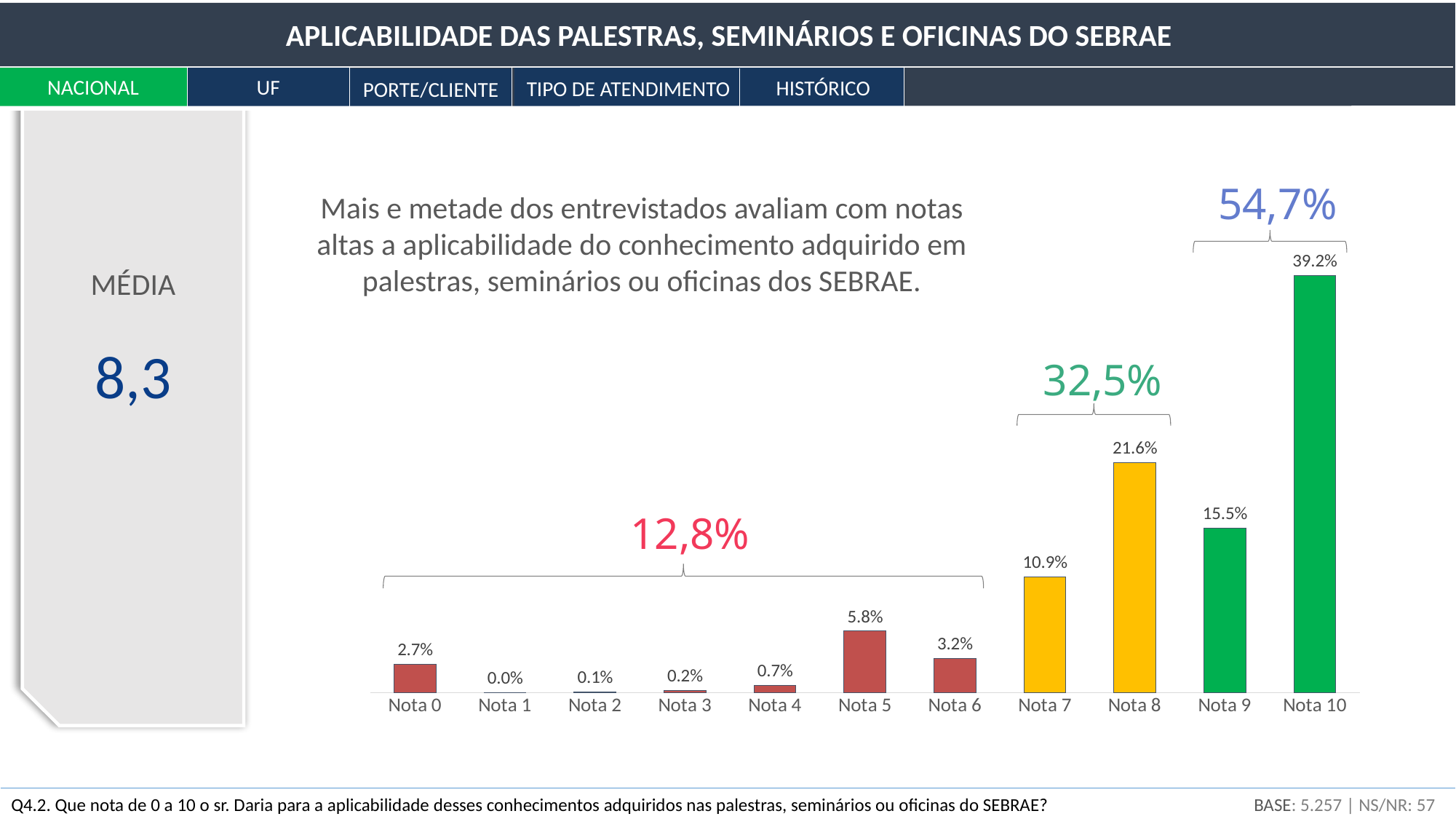
What is the difference between the values for Nota 10 and Nota 9? 23.7% What is the MÉDIA (average) value shown on the left panel? 8,3 What is the combined share shown for Nota 9 and Nota 10 above the bracket? 54,7% What is the combined share shown for Nota 0 through Nota 6 above the bracket? 12,8% What kind of chart is shown? bar chart What is the value for Nota 5? 5.8% Which category has the lowest value? Nota 1 What is the value for Nota 8? 21.6% Which category has the highest value? Nota 10 What is the value for Nota 10? 39.2% Which is larger, the value for Nota 7 or the value for Nota 6? Nota 7 How many categories are shown on the x axis? 11